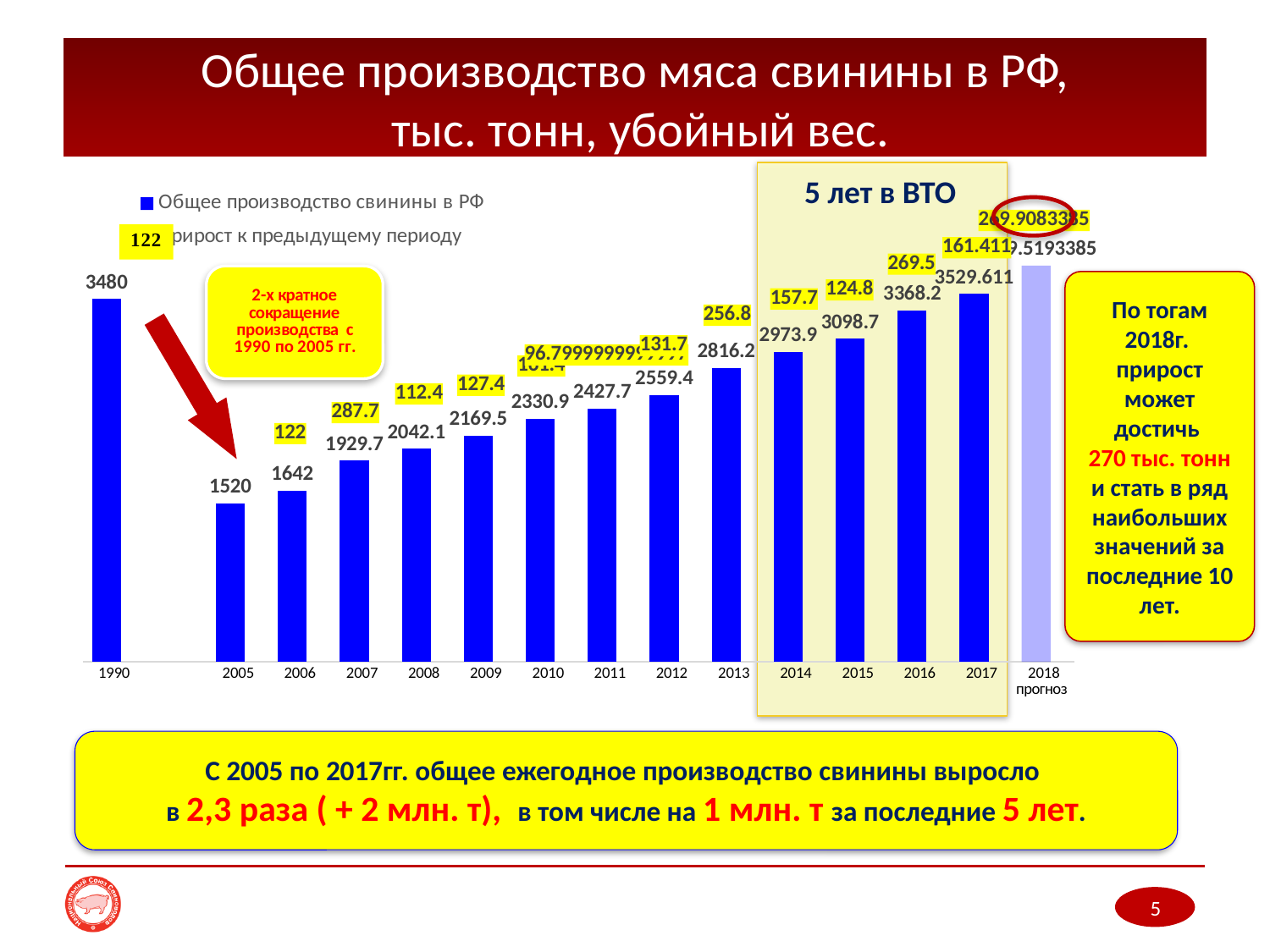
What is the value of the increase to the previous period (прирост) shown for 2016? 269.5 How many years (categories) are shown on the x axis? 15 What kind of chart is shown on the slide? bar chart Do the production values rise or fall from 2005 to 2017? rise What is the title of the chart? Общее производство мяса свинины в РФ, тыс. тонн, убойный вес. What is the total pork production value shown for 1990? 3480 What is the total pork production value shown for 2017? 3529.611 What is the difference between the production values for 2013 and 2012? 256.8 What is the total pork production value shown for 2005? 1520 Which is larger, the production value for 1990 or for 2017? 2017 Which year has the lowest total pork production bar? 2005 How many series does the legend list? 2